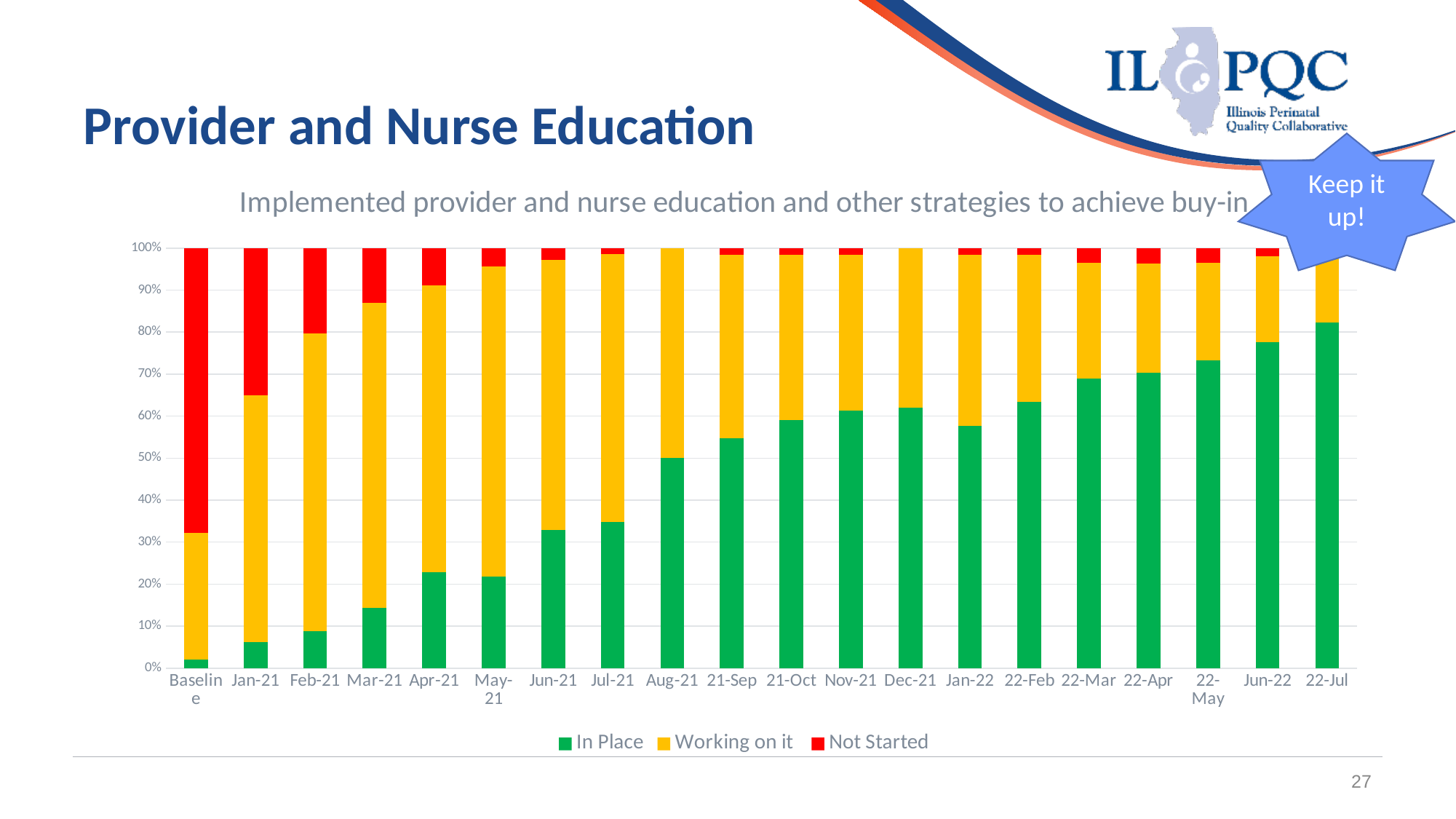
How many categories are shown along the x axis? 20 Which category has the lowest In Place share? Baseline What kind of chart is shown on the slide? Stacked bar chart Does the In Place share generally rise or fall from Baseline to 22-Jul? Rise Is the In Place value for Aug-21 greater or less than 40%? greater Is the In Place value for Jan-21 greater or less than 10%? less How many series does the legend list? 3 What is the title of the chart? Implemented provider and nurse education and other strategies to achieve buy-in Which category has the highest In Place share? 22-Jul Which has a larger In Place share, Jun-22 or Jan-22? Jun-22 Which category has the largest Not Started share? Baseline Is the In Place value for 22-Jul greater or less than 80%? greater